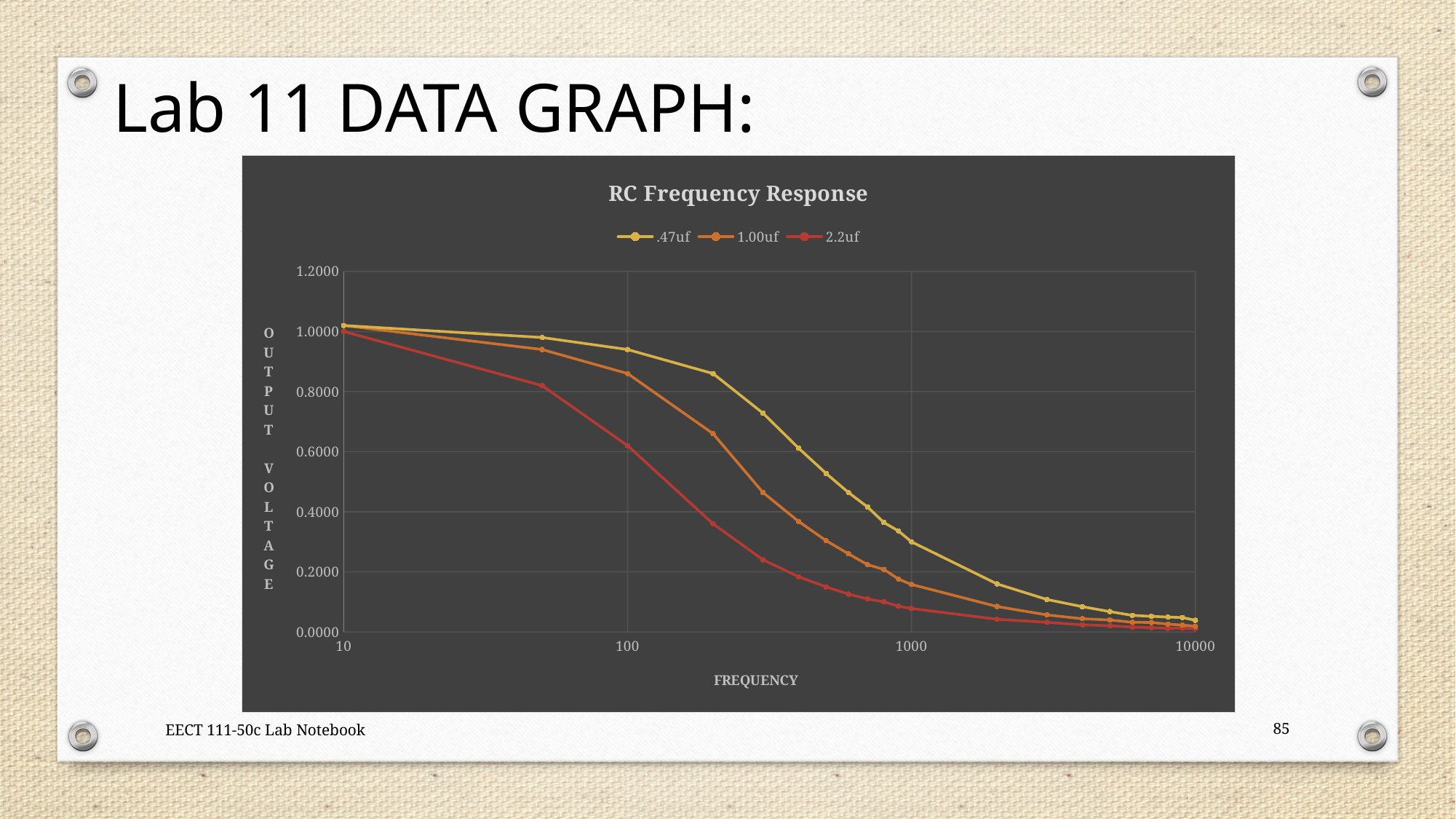
Does the output voltage for the 2.2uf series rise or fall as frequency increases? fall What kind of chart is shown on the slide? line chart Does the output voltage for the .47uf series rise or fall as frequency increases? fall Is the output voltage for the 1.00uf series at a frequency of 1000 greater or less than 0.4000? less What is the title of the chart? RC Frequency Response Is the output voltage for the 2.2uf series at a frequency of 1000 greater or less than 0.2000? less At a frequency of 100, which series has the higher output voltage, 1.00uf or 2.2uf? 1.00uf Which series has the lowest output voltage at a frequency of 100? 2.2uf At a frequency of 1000, which series has the higher output voltage, .47uf or 2.2uf? .47uf How many series does the legend of the RC Frequency Response chart list? 3 What is the label on the x axis of the chart? FREQUENCY Is the output voltage for the .47uf series at a frequency of 100 greater or less than 0.8000? greater